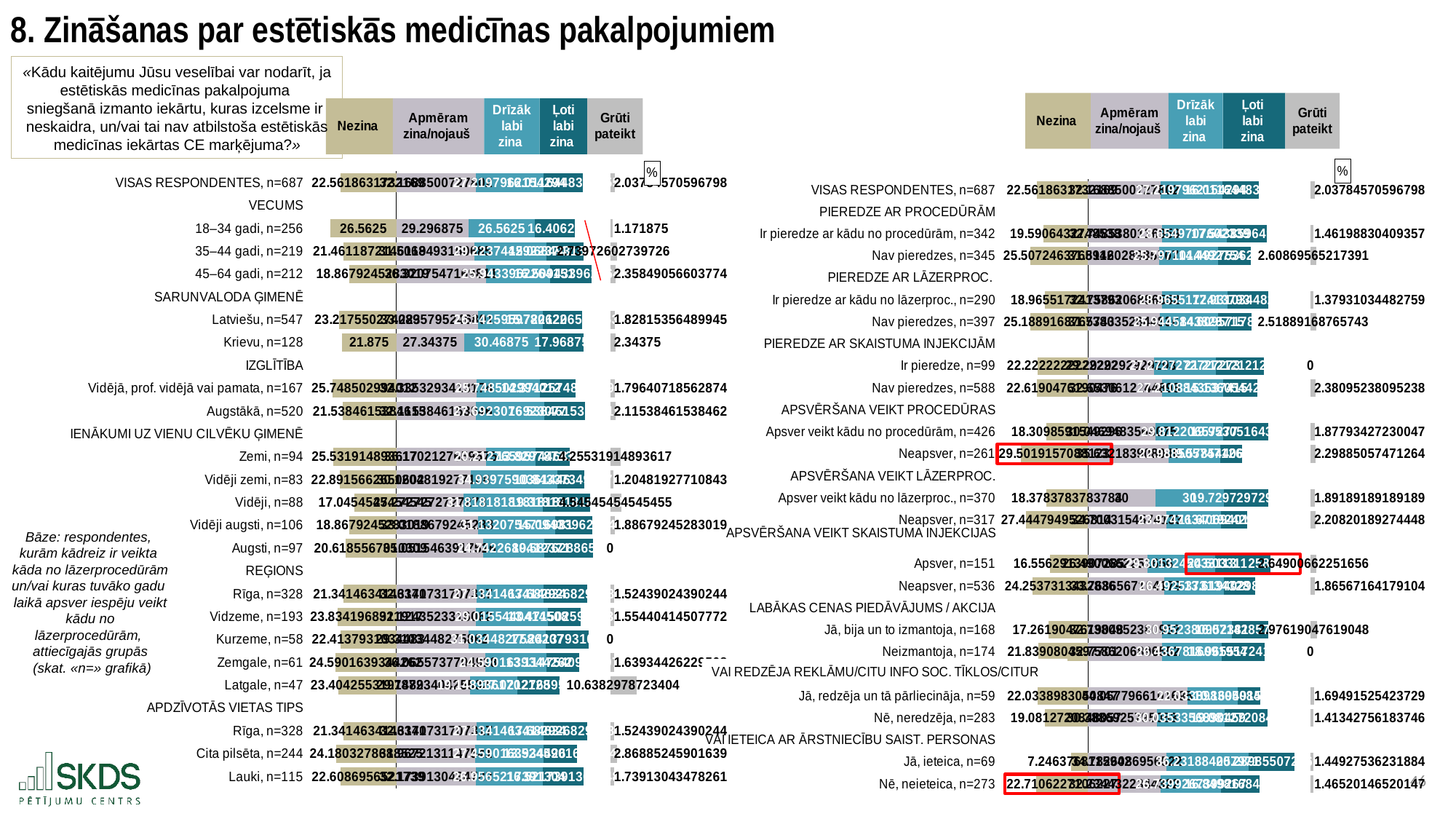
In the left chart, what is the Drīzāk labi zina value for Krievu, n=128? 30.46875 In the left chart, which region under REĢIONS has the highest Grūti pateikt value? Latgale, n=47 In the left chart, which has the larger Nezina value: 18–34 gadi, n=256 or Krievu, n=128? 18–34 gadi, n=256 In the right chart, what is the Grūti pateikt value for Jā, bija un to izmantoja, n=168? 2.97619047619048 In the left chart, what is the Nezina value for 18–34 gadi, n=256? 26.5625 In the left chart, what is the Ļoti labi zina value for Krievu, n=128? 17.96875 In the left chart, what is the difference between the Drīzāk labi zina and Ļoti labi zina values for Krievu, n=128? 12.5 What kind of chart is shown on the left of the slide? Stacked bar chart In the left chart, what is the Apmēram zina/nojauš value for 18–34 gadi, n=256? 29.296875 In the right chart, what is the Grūti pateikt value for Ir pieredze, n=99? 0 How many series does the legend of the left chart list? 5 In the left chart, what is the Grūti pateikt value for Latgale, n=47? 10.6382978723404